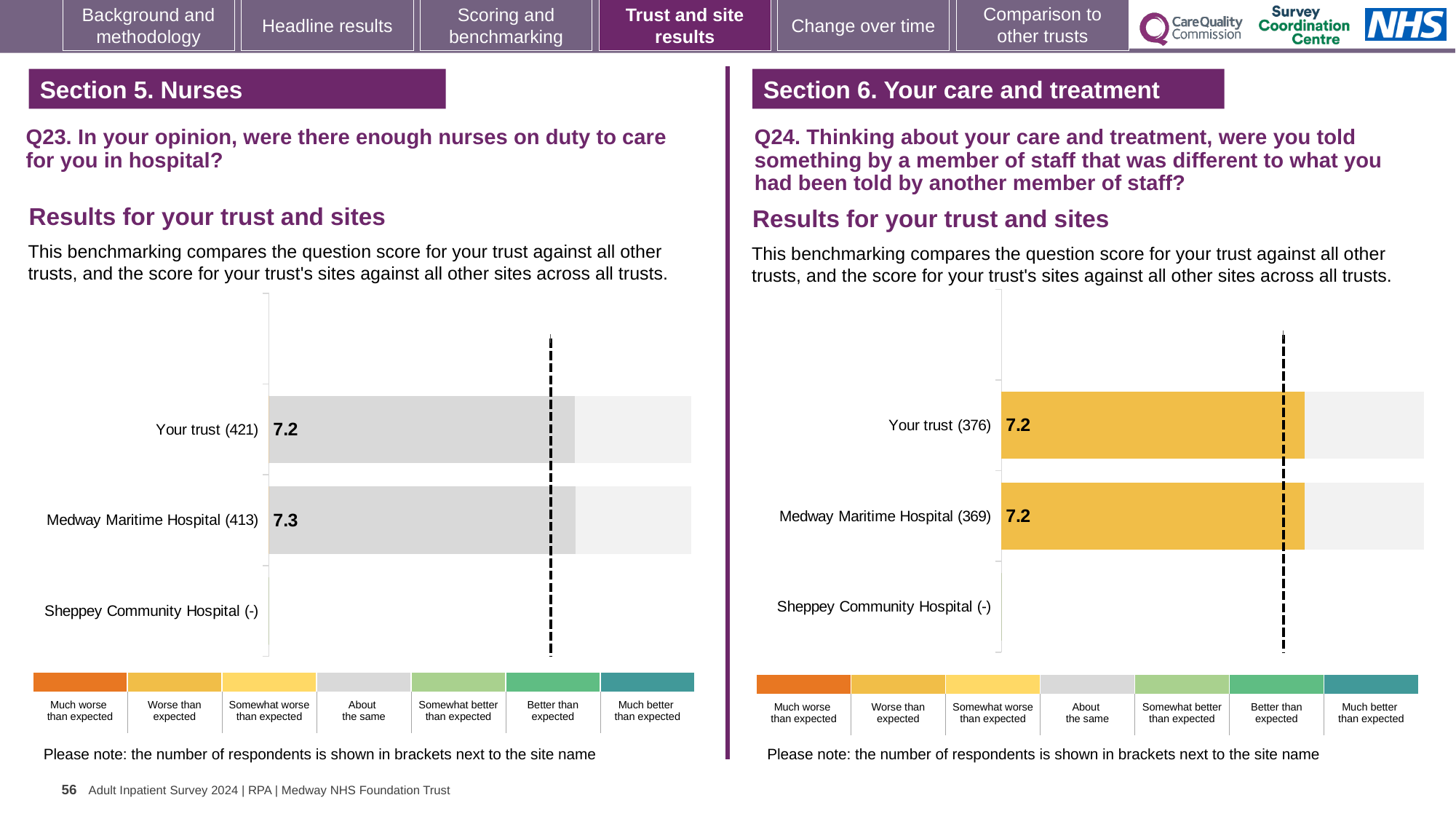
What kind of chart is the Q23 chart on the left? Bar chart In the Q24 chart on the right, which benchmark category does the colour of the bars correspond to according to the legend? Worse than expected In the Q24 chart on the right, what is the score for Your trust? 7.2 In the Q23 chart on the left, what is the score for Your trust? 7.2 In the Q23 chart on the left, which is larger: the score for Your trust or for Medway Maritime Hospital? Medway Maritime Hospital In the Q23 chart on the left, which benchmark category does the colour of the bars correspond to according to the legend? About the same In the Q24 chart on the right, what is the score for Medway Maritime Hospital? 7.2 In the Q23 chart on the left, how many respondents are shown in brackets for Your trust? 421 In the Q24 chart on the right, how many respondents are shown in brackets for Medway Maritime Hospital? 369 In the Q23 chart on the left, what is the difference between the Medway Maritime Hospital score and the Your trust score? 0.1 In the Q23 chart on the left, what is the score for Medway Maritime Hospital? 7.3 How many categories (rows) are listed on the y axis of the Q24 chart on the right? 3